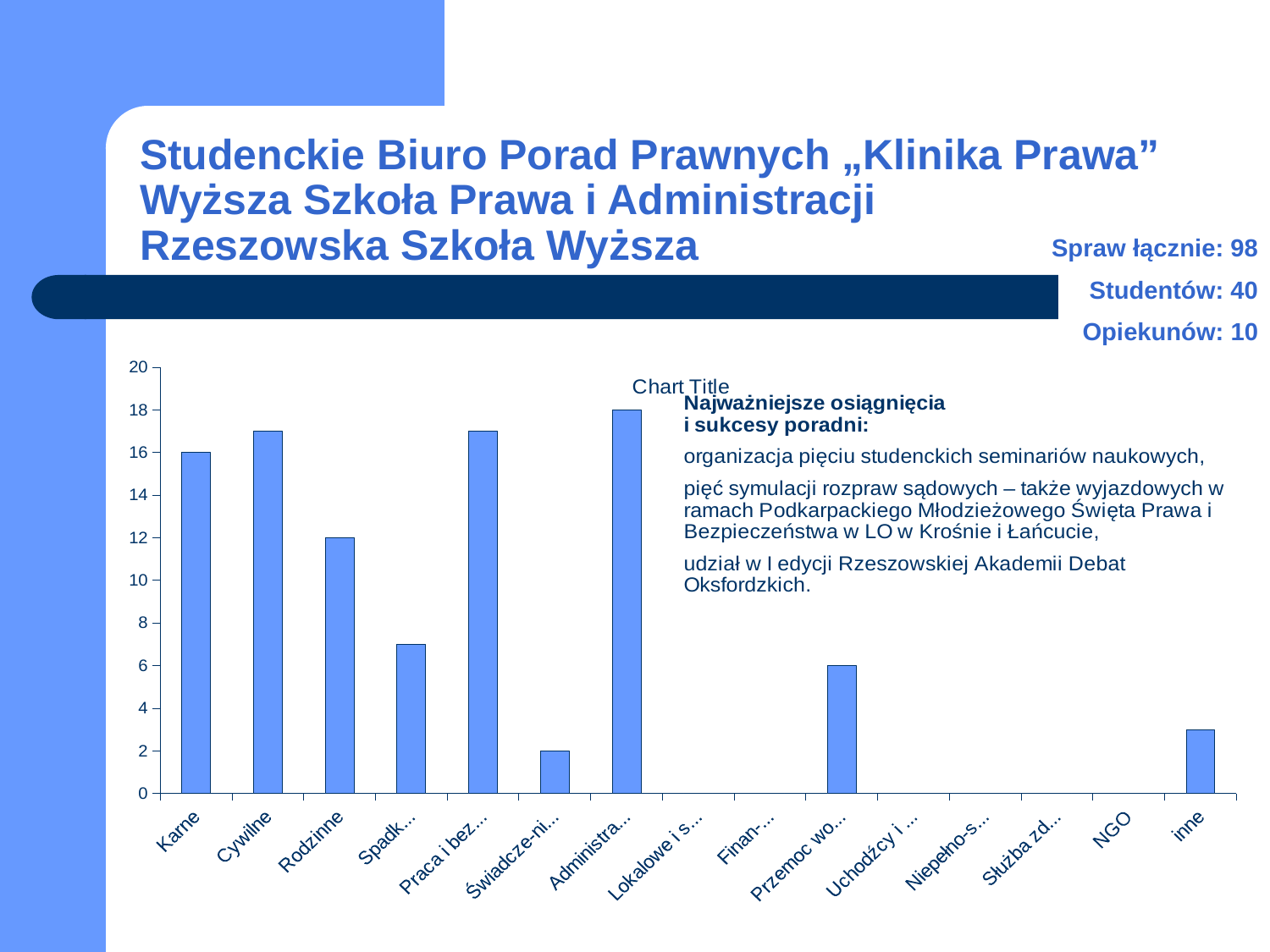
What is the value for Administra...? 18 Is the value for Spadk... greater or less than 8? less Which is larger, the value for Przemoc wo... or the value for inne? Przemoc wo... What is the title shown on the chart? Chart Title What type of chart is shown on the slide? bar chart Is the value for Cywilne greater or less than 16? greater How many categories are shown on the x axis of the chart? 15 What is the value for Rodzinne? 12 Which category has the highest value? Administra... What is the difference between the values for Karne and Rodzinne? 4 What is the value for Karne? 16 What is the value for Przemoc wo...? 6